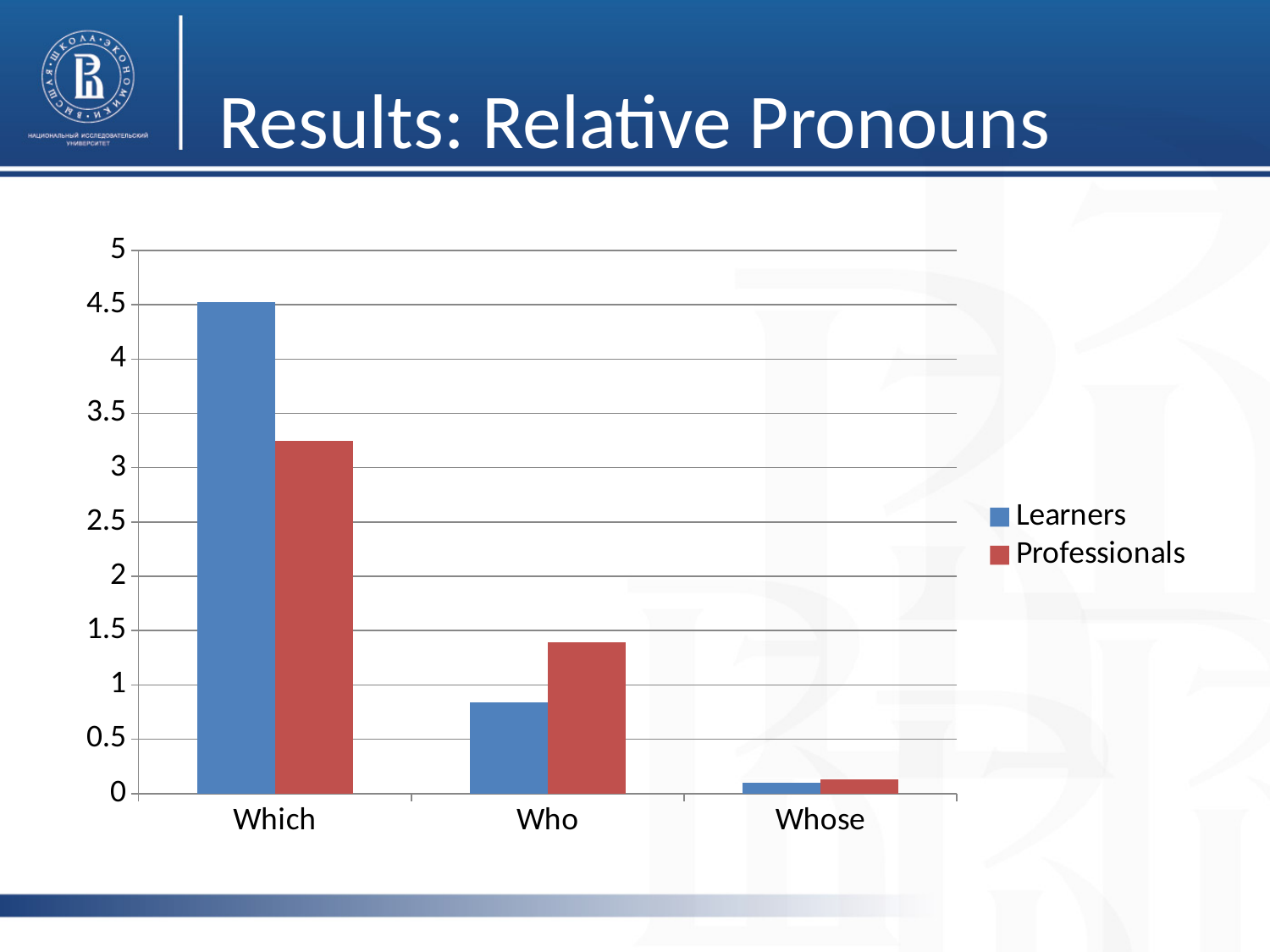
How many series does the legend list? 2 What kind of chart is shown on the slide? bar chart How many categories are shown on the x axis? 3 Is the value for Learners in the category Who greater or less than 1? less Do the Learners values rise or fall from Which to Whose along the x axis? fall For the category Who, which series has the larger value, Learners or Professionals? Professionals Which category has the lowest value for Professionals? Whose Which category has the highest value for Learners? Which Is the value for Learners in the category Which greater or less than 4? greater Is the value for Professionals in the category Which greater or less than 3? greater What is the title of the slide containing the chart? Results: Relative Pronouns For the category Which, which series has the larger value, Learners or Professionals? Learners